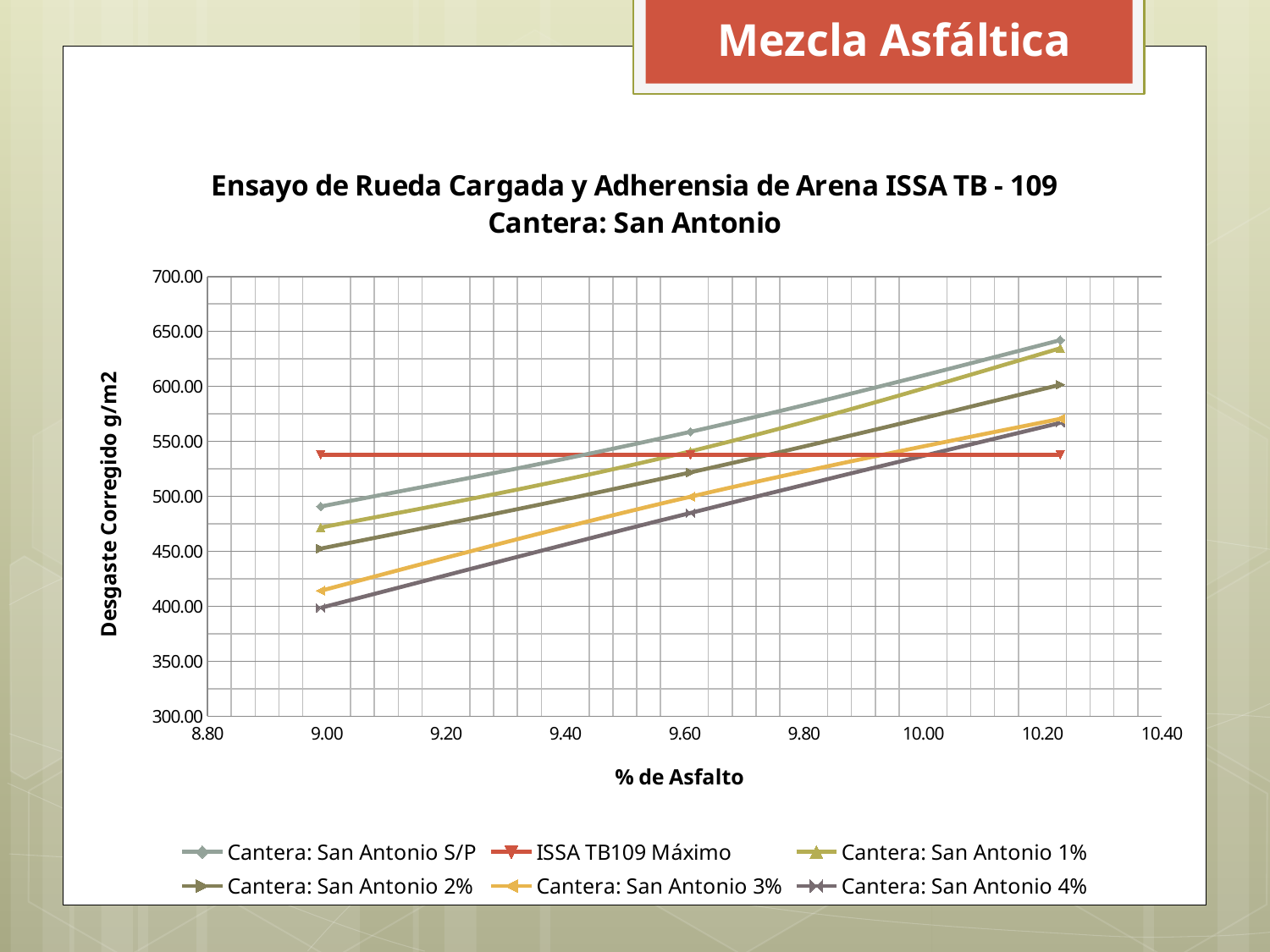
Is the value for Cantera: San Antonio 4% at its leftmost point greater or less than 450? less Is the value for Cantera: San Antonio S/P at its rightmost point greater or less than 600? greater How many series does the legend list? 6 What is the title of the chart? Ensayo de Rueda Cargada y Adherensia de Arena ISSA TB - 109 Cantera: San Antonio Which series stays flat across the whole range of % de Asfalto? ISSA TB109 Máximo How many data points does the Cantera: San Antonio S/P series have? 3 What kind of chart is shown on the slide? Line chart Which series has the lowest value at the leftmost data point (around 9.00 % de Asfalto)? Cantera: San Antonio 4% At the leftmost data point, which is larger: Cantera: San Antonio S/P or Cantera: San Antonio 2%? Cantera: San Antonio S/P What is the label of the vertical axis? Desgaste Corregido g/m2 Does the Cantera: San Antonio 4% series rise or fall as % de Asfalto increases? Rises Is the value of the ISSA TB109 Máximo line greater or less than 500? greater